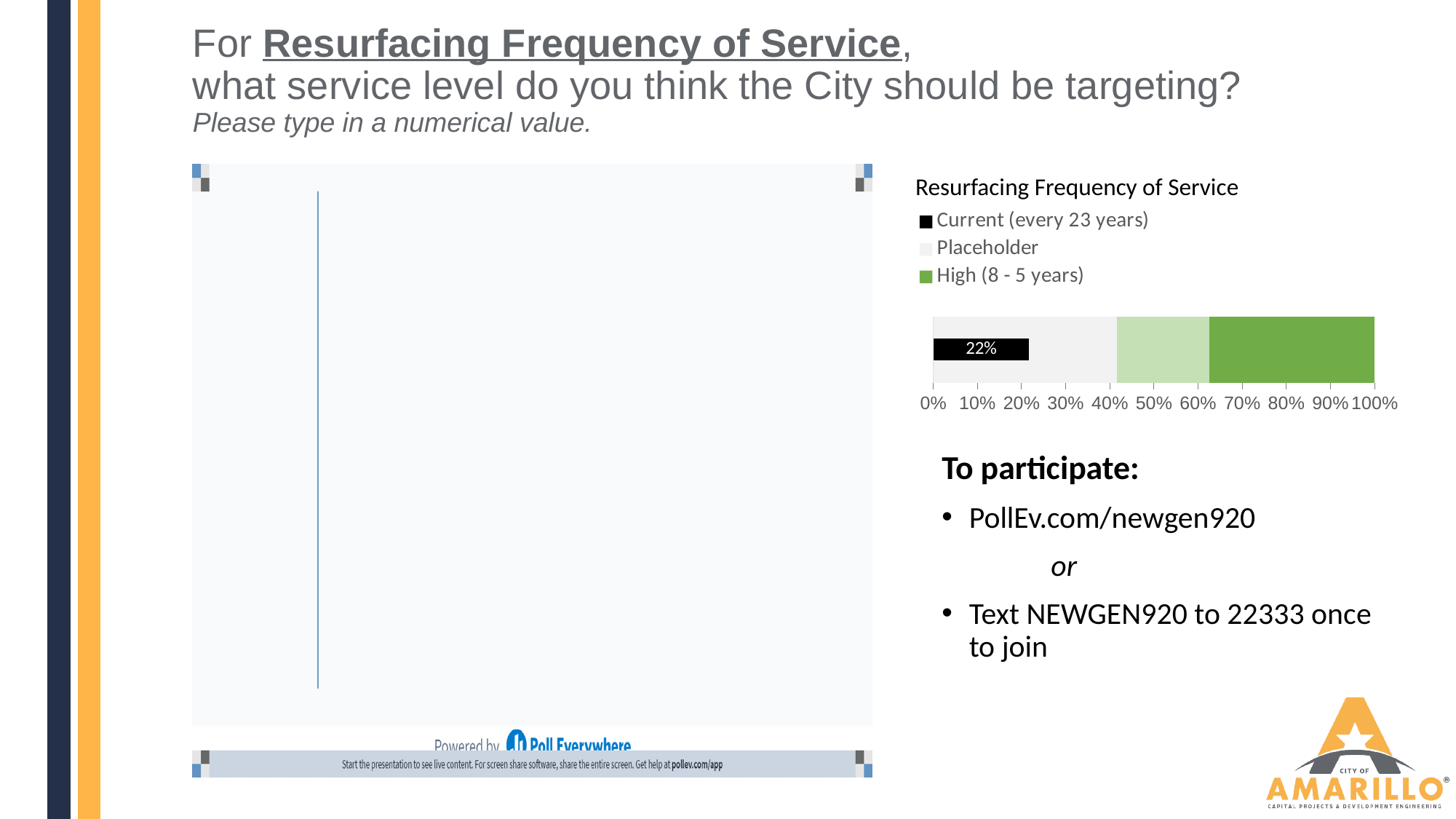
Is the value for Current (every 23 years) greater or less than 20%? greater What kind of chart is the Resurfacing Frequency of Service chart? bar chart What value is printed on the black bar in the Resurfacing Frequency of Service chart? 22% What is the highest value shown on the x axis of the Resurfacing Frequency of Service chart? 100% Which legend entry in the Resurfacing Frequency of Service chart is shown in green? High (8 - 5 years) How many series does the legend of the Resurfacing Frequency of Service chart list? 3 Is the value for Current (every 23 years) greater or less than 30%? less What is the value shown for Current (every 23 years) in the Resurfacing Frequency of Service chart? 22% What is the title of the chart on the right side of the slide? Resurfacing Frequency of Service